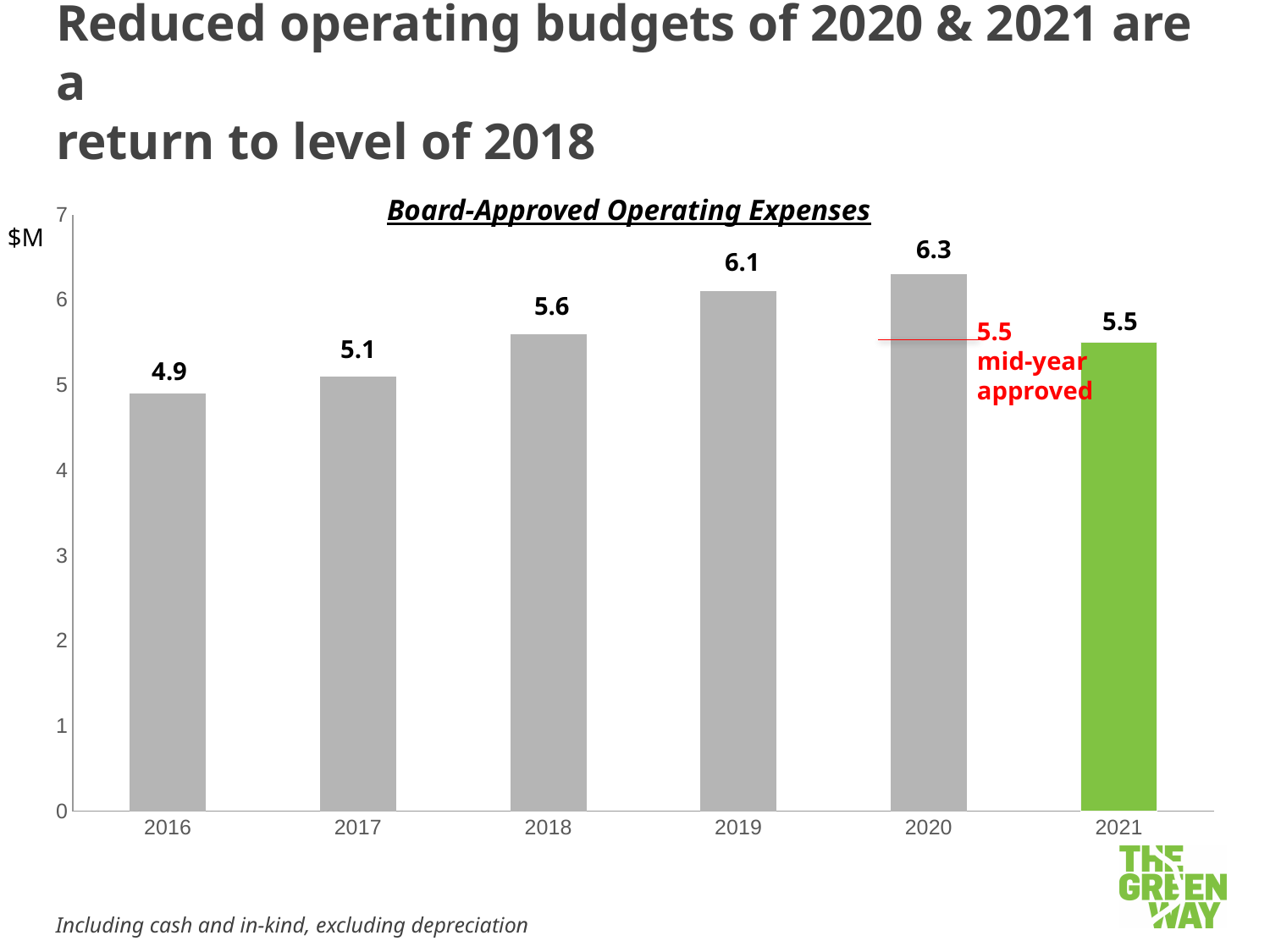
What kind of chart is shown on the slide? bar chart Which year has the highest board-approved operating expenses? 2020 Which year has the lowest board-approved operating expenses? 2016 Is the value for 2019 greater or less than 6? greater How many years are shown on the x axis? 6 Which is larger, the value for 2017 or the value for 2018? 2018 What is the board-approved operating expense value for 2016? 4.9 What is the board-approved operating expense value for 2019? 6.1 What is the difference between the 2018 value and the 2016 value? 0.7 What is the difference between the 2020 value and the 2021 value? 0.8 What is the value shown for 2021? 5.5 What is the title of the chart? Board-Approved Operating Expenses